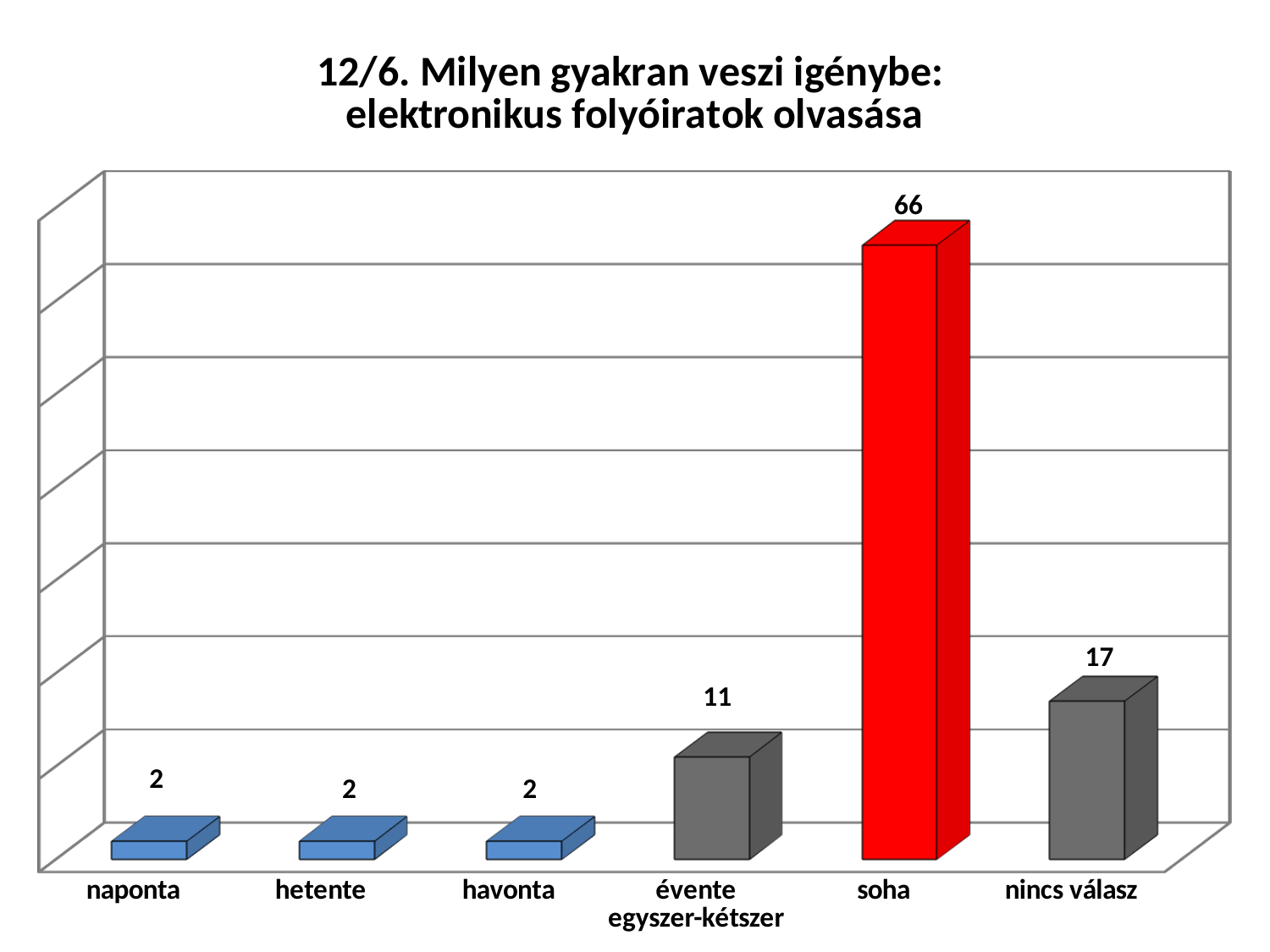
What is the difference between the values for "nincs válasz" and "évente egyszer-kétszer"? 6 How many categories are shown on the x axis? 6 Which is larger, the value for "évente egyszer-kétszer" or the value for "nincs válasz"? nincs válasz What is the value for "naponta"? 2 What is the title of the chart? 12/6. Milyen gyakran veszi igénybe: elektronikus folyóiratok olvasása Which category has the highest value? soha What is the value for "évente egyszer-kétszer"? 11 What kind of chart is shown on the slide? bar chart What is the difference between the values for "soha" and "nincs válasz"? 49 What colour is the bar for "soha"? red What is the value for "nincs válasz"? 17 What is the value for "soha"? 66